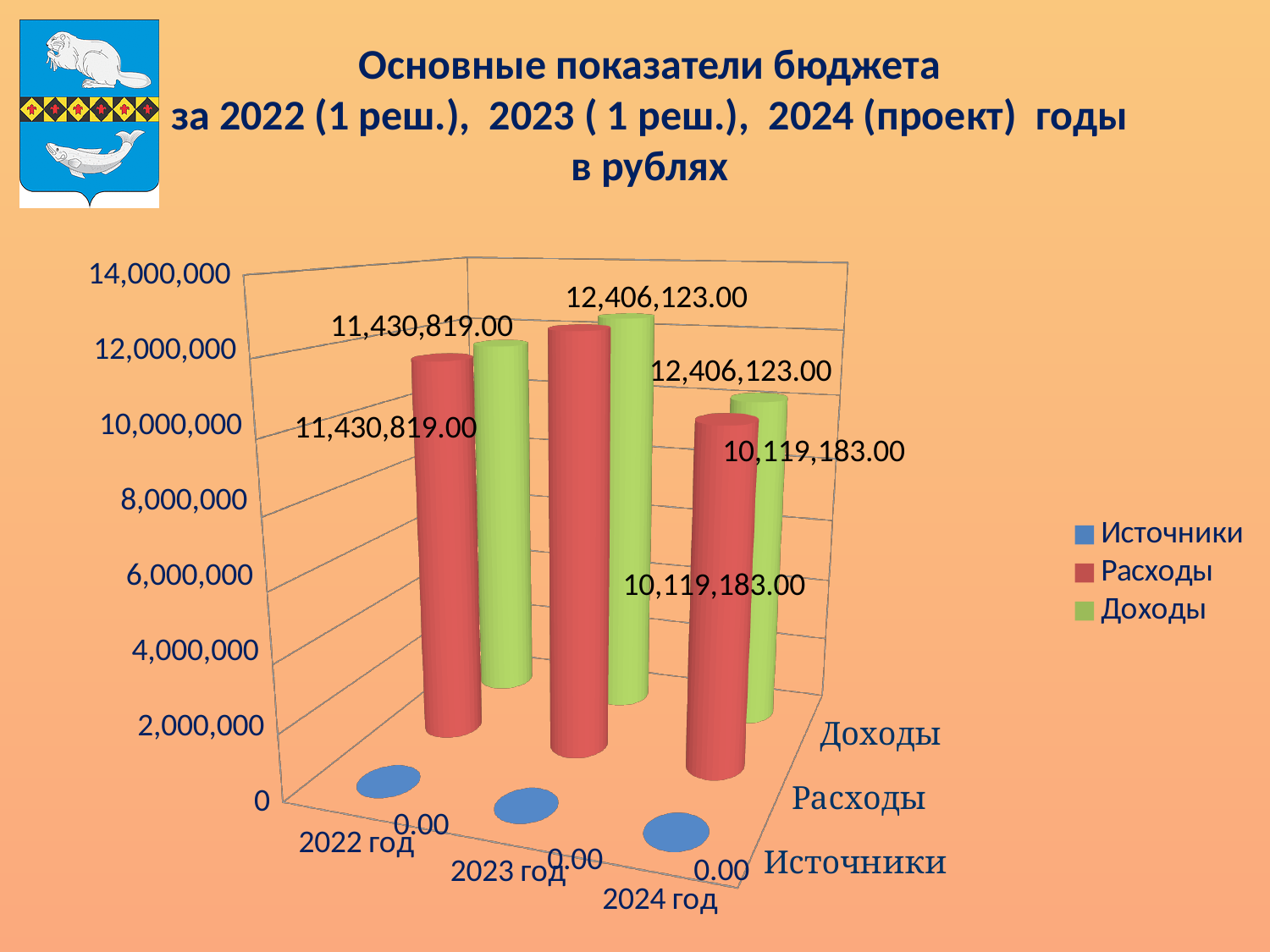
How many series does the legend list? 3 What kind of chart is shown on the slide? bar chart Which year has the lowest value for Расходы? 2024 год What is the difference between Доходы in 2023 год and Доходы in 2024 год? 2,286,940.00 What is the value of Источники for 2023 год? 0.00 What is the value of Доходы for 2022 год? 11,430,819.00 Which is larger: Расходы for 2022 год or Расходы for 2023 год? Расходы for 2023 год Which series is shown in green in the legend? Доходы What is the value of Доходы for 2024 год? 10,119,183.00 Which year has the highest value for Доходы? 2023 год How many year categories are shown on the x axis? 3 What is the value of Расходы for 2023 год? 12,406,123.00